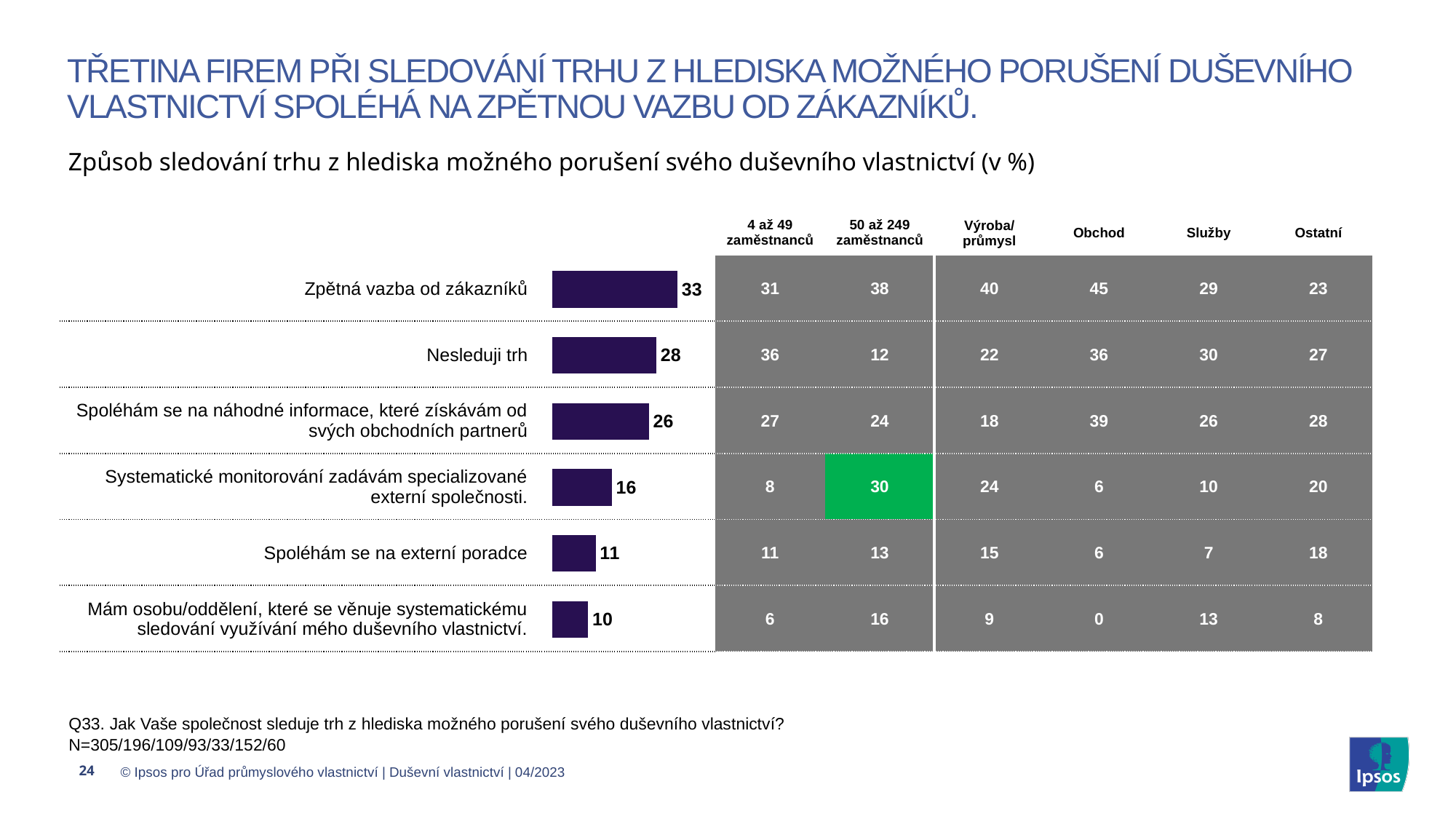
What is the difference between the values for "Zpětná vazba od zákazníků" and "Nesleduji trh"? 5 What is the value for "Nesleduji trh" in the bar chart? 28 Do the bar values rise or fall from the top category to the bottom category? Fall Which is larger: the value for "Nesleduji trh" or the value for "Spoléhám se na náhodné informace, které získávám od svých obchodních partnerů"? Nesleduji trh What kind of chart is shown on the slide? Bar chart What is the difference between the values for "Spoléhám se na náhodné informace, které získávám od svých obchodních partnerů" and "Systematické monitorování zadávám specializované externí společnosti."? 10 Which category has the highest value in the bar chart? Zpětná vazba od zákazníků How many categories are shown in the bar chart? 6 Which category has the lowest value in the bar chart? Mám osobu/oddělení, které se věnuje systematickému sledování využívání mého duševního vlastnictví. What is the value for "Systematické monitorování zadávám specializované externí společnosti." in the bar chart? 16 What is the value for "Spoléhám se na externí poradce" in the bar chart? 11 What is the value for "Zpětná vazba od zákazníků" in the bar chart? 33